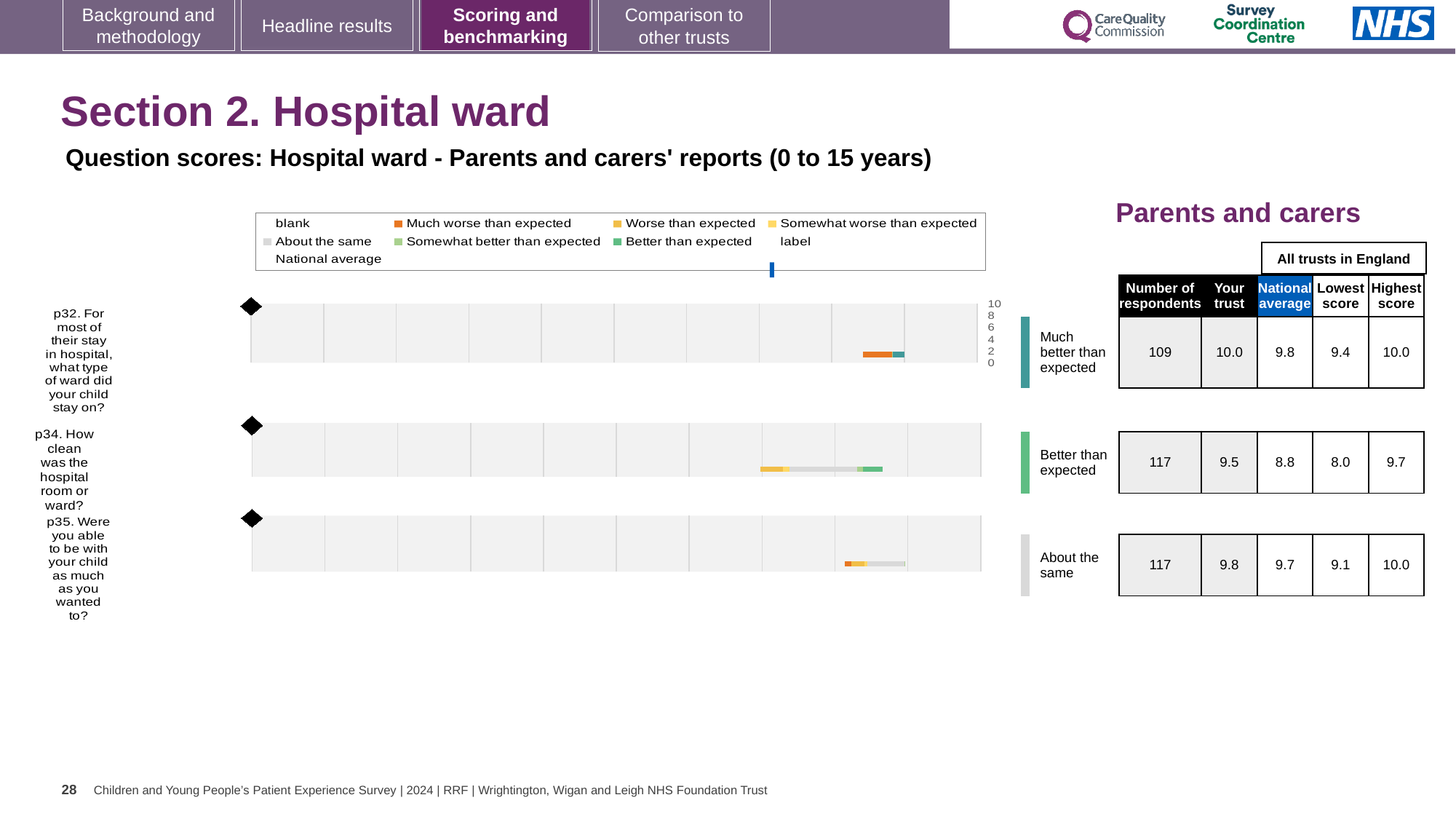
How many questions are plotted in the chart? 3 What is the highest score among all trusts in England for p35 (Were you able to be with your child as much as you wanted to?)? 10.0 Which question has the highest 'Your trust' score? p32 Which question has the lowest 'Your trust' score? p34 What kind of chart is used to show the question scores on this slide? bar chart What is the 'Your trust' score for p32 (For most of their stay in hospital, what type of ward did your child stay on?)? 10.0 How many respondents answered p32? 109 What is the national average score for p34 (How clean was the hospital room or ward?)? 8.8 For p35, which is larger: the 'Your trust' score or the national average? Your trust Which benchmarking category is p34 placed in? Better than expected What is the difference between the 'Your trust' score and the national average for p34? 0.7 What is the lowest score among all trusts in England for p34? 8.0